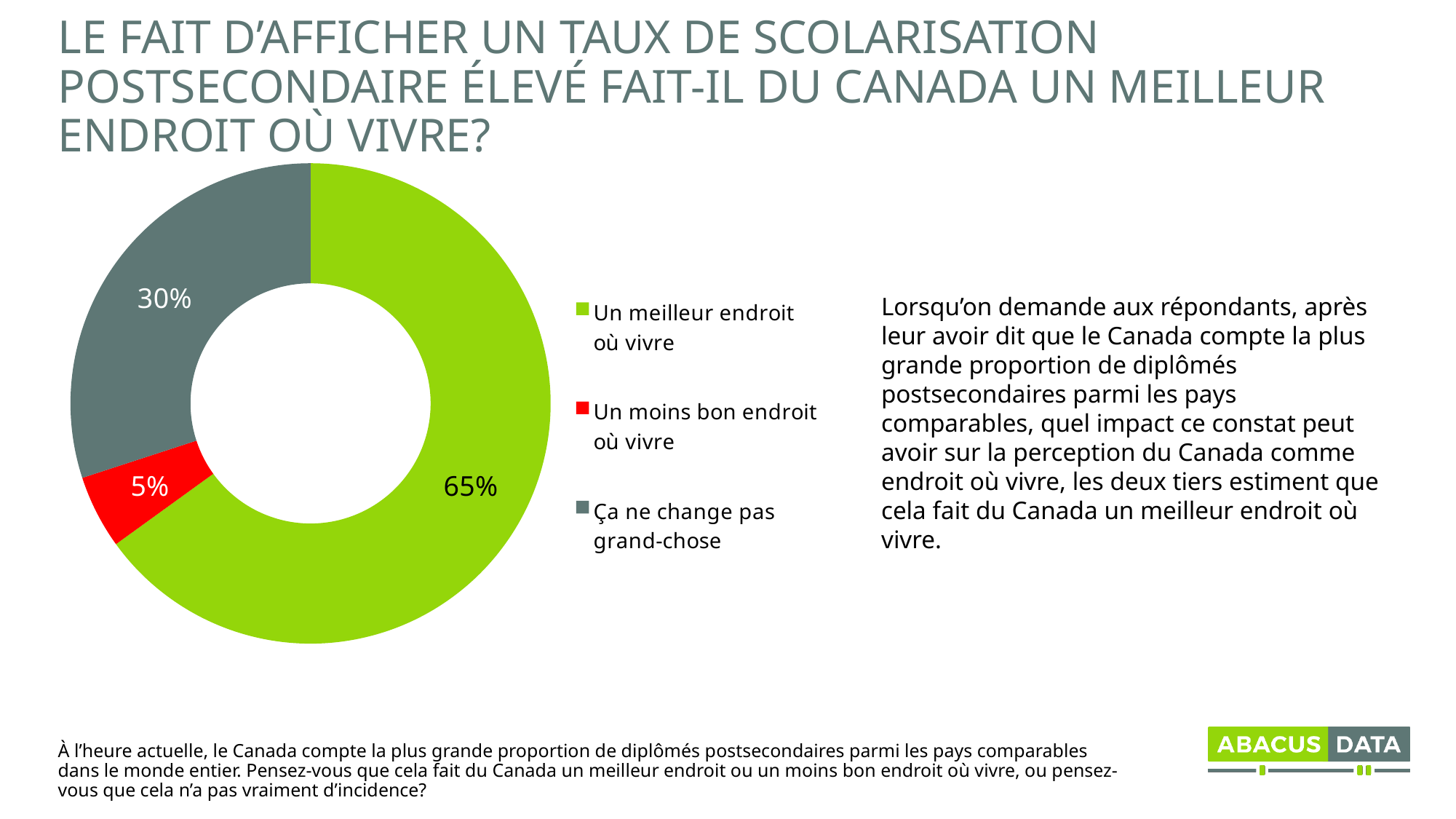
What is the difference in percentage points between 'Ça ne change pas grand-chose' and 'Un moins bon endroit où vivre'? 25 How many categories are shown in the pie chart? 3 Which is larger: the share for 'Ça ne change pas grand-chose' or the share for 'Un moins bon endroit où vivre'? Ça ne change pas grand-chose Which response category has the largest share of the pie? Un meilleur endroit où vivre What percentage of respondents said 'Ça ne change pas grand-chose'? 30% Which response category has the smallest share of the pie? Un moins bon endroit où vivre What colour represents 'Un moins bon endroit où vivre' in the chart? Red What kind of chart is shown on the slide? Pie chart (donut) What percentage of respondents said 'Un moins bon endroit où vivre'? 5% What colour represents 'Ça ne change pas grand-chose' in the chart? Grey What percentage of respondents said it makes Canada 'Un meilleur endroit où vivre'? 65% What is the difference in percentage points between 'Un meilleur endroit où vivre' and 'Ça ne change pas grand-chose'? 35